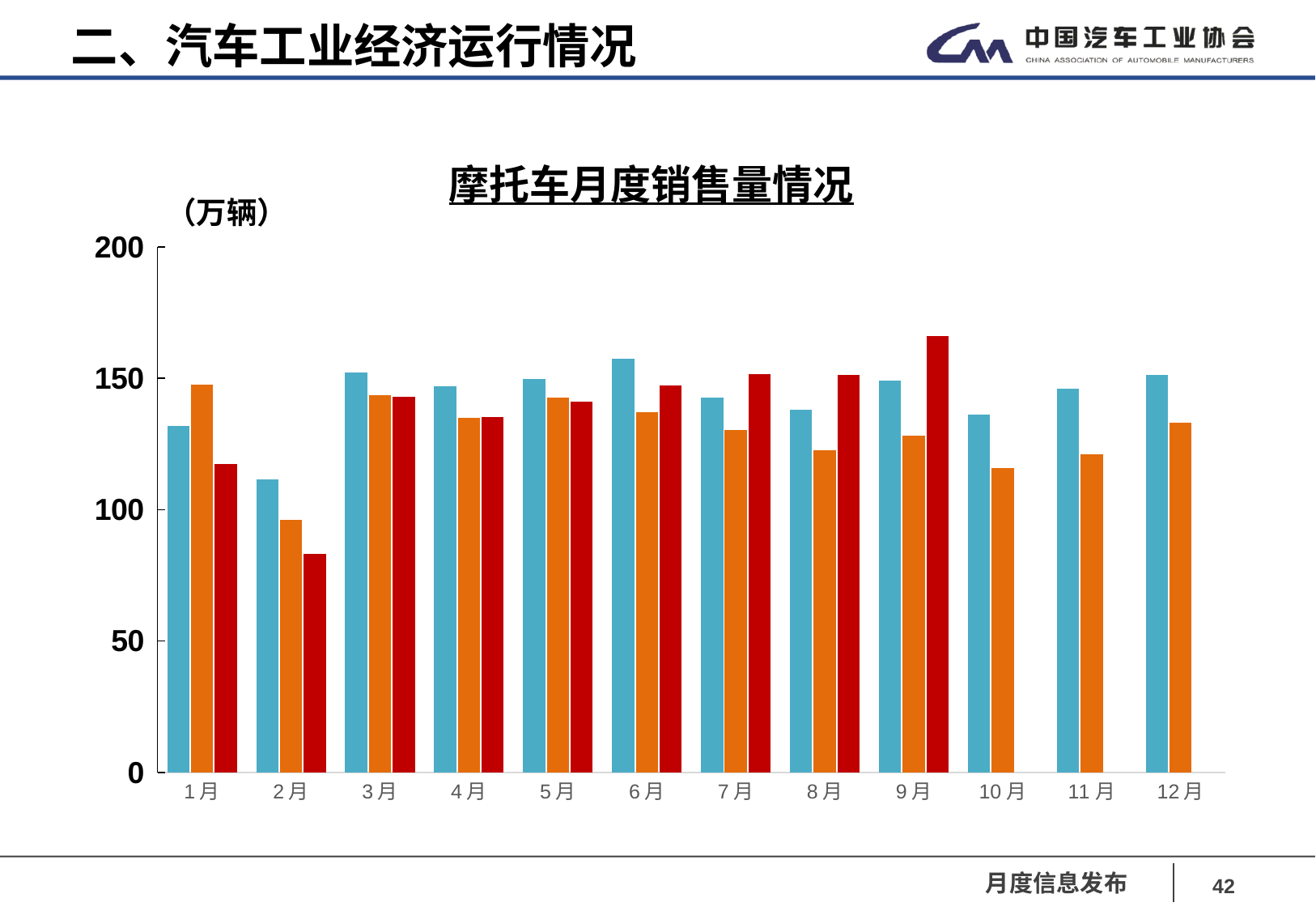
Is the value of the blue bar for 1月 greater or less than 150? less How many months are shown along the x axis of the chart? 12 What is the title of the chart? 摩托车月度销售量情况 Is the value of the red bar for 2月 greater or less than 100? less In which month is the red bar the highest? 9月 In which month is the red bar the lowest? 2月 For 9月, which is larger, the blue bar or the red bar? the red bar Is the value of the red bar for 9月 greater or less than 150? greater What kind of chart is shown on the slide? bar chart In which month is the blue bar the lowest? 2月 For 1月, which is larger, the orange bar or the red bar? the orange bar What unit is shown for the vertical axis of the chart? 万辆